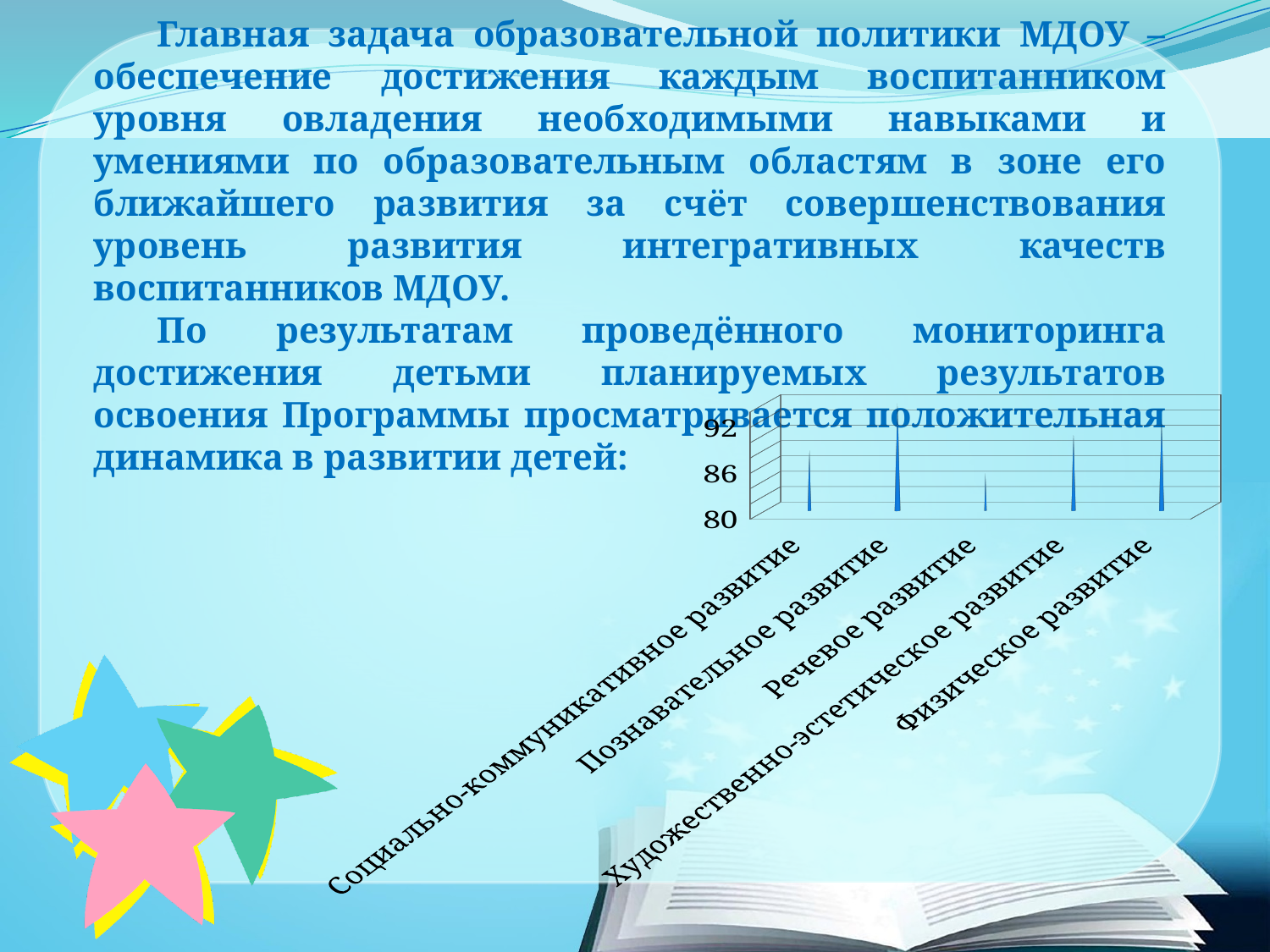
Is the value for Познавательное развитие greater or less than 86? greater What is the lowest tick value shown on the chart's vertical axis? 80 What kind of chart is shown on the slide? bar chart Is the value for Физическое развитие greater or less than 86? greater Which is larger, the value for Физическое развитие or the value for Речевое развитие? Физическое развитие What is the highest tick value shown on the chart's vertical axis? 92 Is the value for Социально-коммуникативное развитие greater or less than 86? greater Which category has the lowest value on the chart? Речевое развитие Which is larger, the value for Познавательное развитие or the value for Речевое развитие? Познавательное развитие How many categories are shown on the chart's x axis? 5